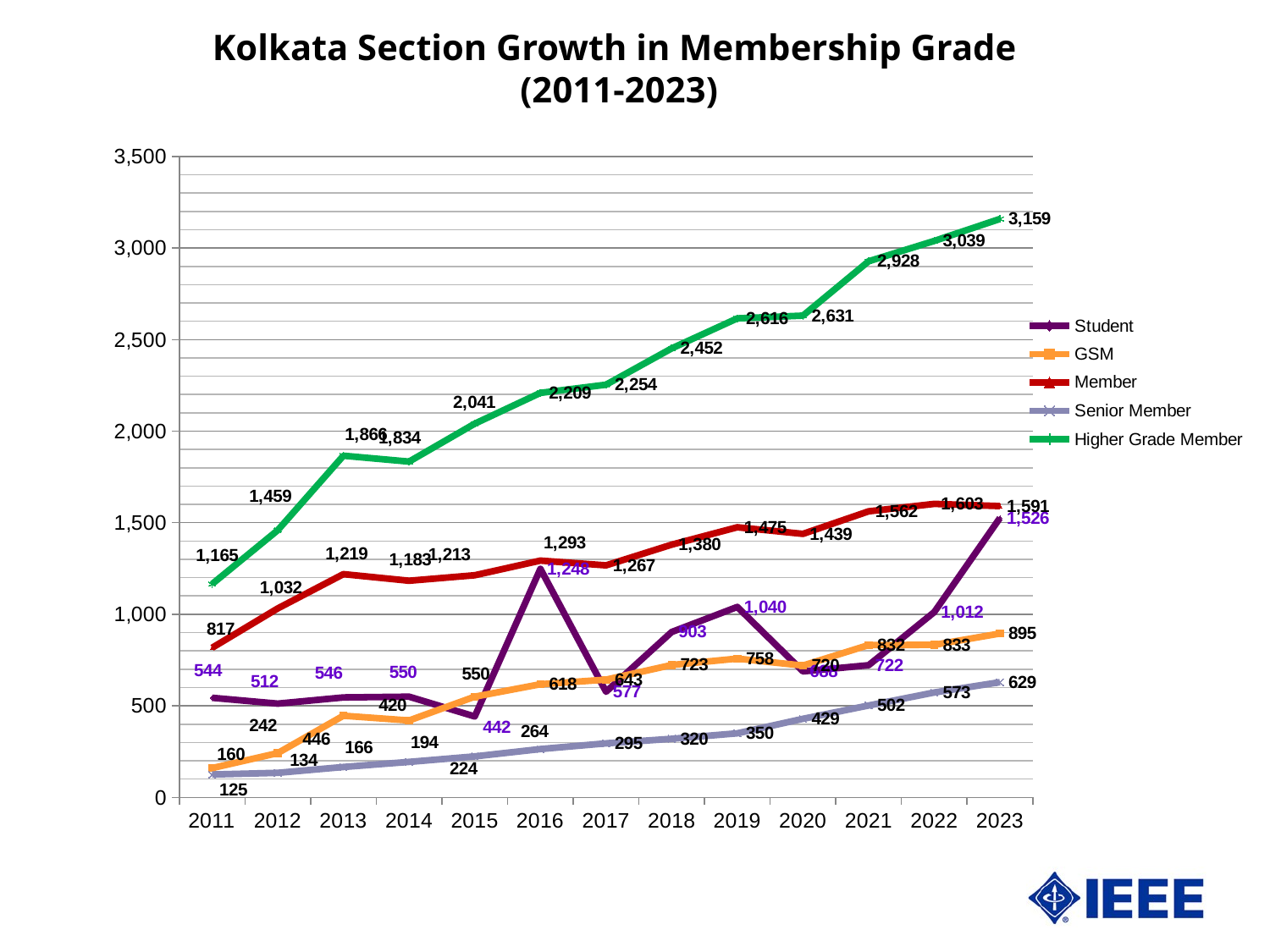
In which year is the Higher Grade Member value highest? 2023 How many years are plotted along the x axis? 13 Which is larger in 2023, the GSM value or the Senior Member value? GSM What is the Senior Member value for 2011? 125 What is the difference between the Higher Grade Member values for 2023 and 2011? 1,994 How many series does the legend list? 5 What kind of chart is shown on the slide? line chart What is the Higher Grade Member value for 2023? 3,159 Does the Senior Member series rise or fall from 2011 to 2023? rise In which year is the Senior Member value lowest? 2011 What is the Member value for 2022? 1,603 What is the GSM value for 2019? 758